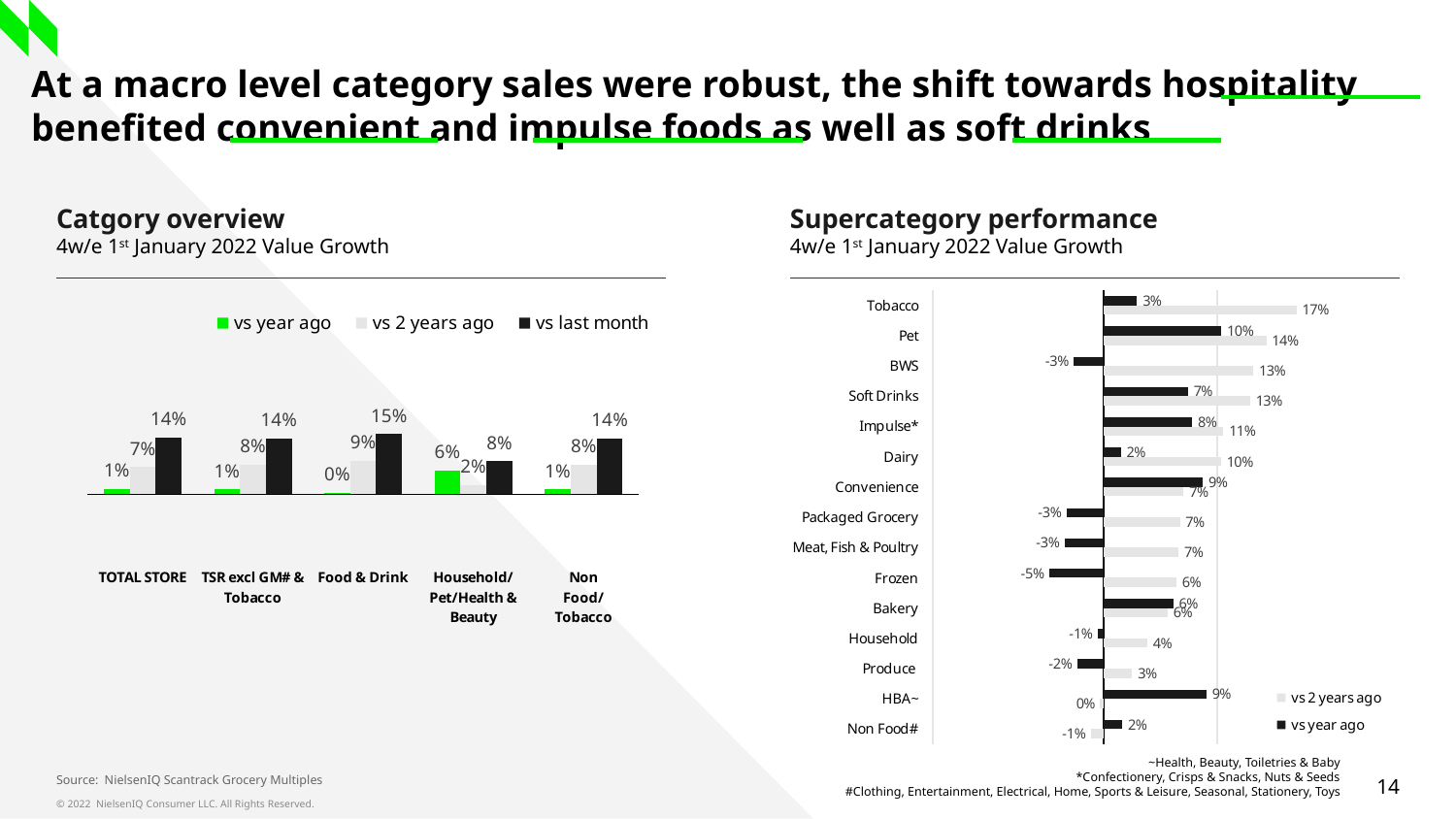
In the Supercategory performance chart, how many supercategories are listed? 15 In the Supercategory performance chart, which supercategory has the highest value vs 2 years ago? Tobacco In the Supercategory performance chart, which supercategory has the lowest value vs year ago? Frozen What kind of chart is the Supercategory performance chart? Bar chart In the Catgory overview chart, how many series does the legend list? 3 In the Supercategory performance chart, what is the difference between the vs 2 years ago and vs year ago values for BWS? 16 percentage points In the Supercategory performance chart, what is the value for Frozen vs year ago? -5% In the Catgory overview chart, what is the vs year ago value for Household/Pet/Health & Beauty? 6% In the Supercategory performance chart, what is the value for Tobacco vs 2 years ago? 17% In the Catgory overview chart, what is the vs last month value for Food & Drink? 15% In the Catgory overview chart, which category has the highest vs year ago value? Household/Pet/Health & Beauty In the Supercategory performance chart, which is larger for Convenience: vs year ago or vs 2 years ago? vs year ago